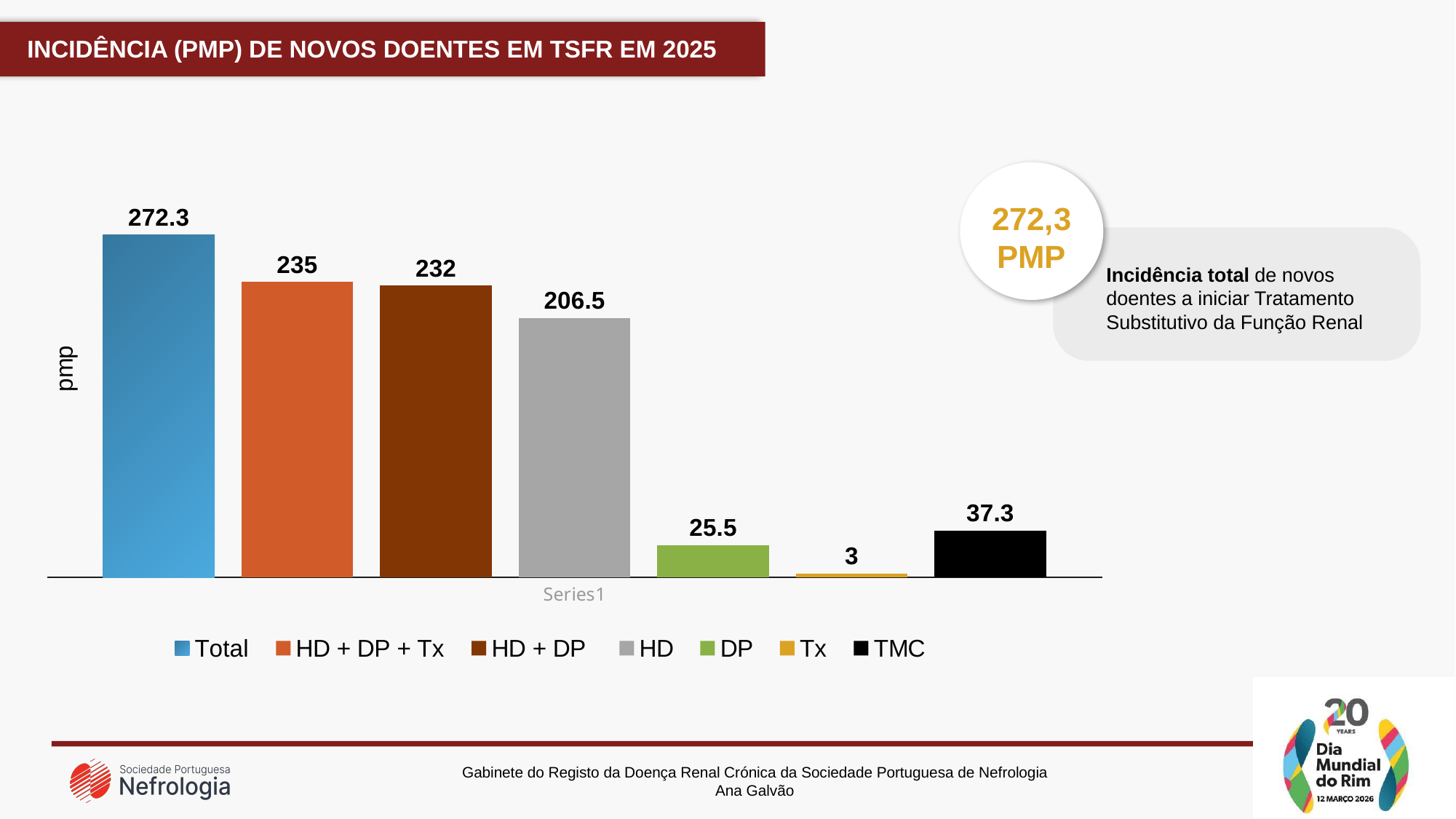
What is the value for HD? 206.5 How many series does the legend list? 7 What is the value for Total? 272.3 Which series has the highest value? Total What is the difference between the values for HD + DP + Tx and HD + DP? 3 What is the difference between the values for TMC and DP? 11.8 What is the label on the vertical axis of the chart? pmp What is the value for TMC? 37.3 Which is larger, the value for DP or the value for TMC? TMC What is the value for Tx? 3 Which series has the lowest value? Tx What kind of chart is shown on the slide? Bar chart